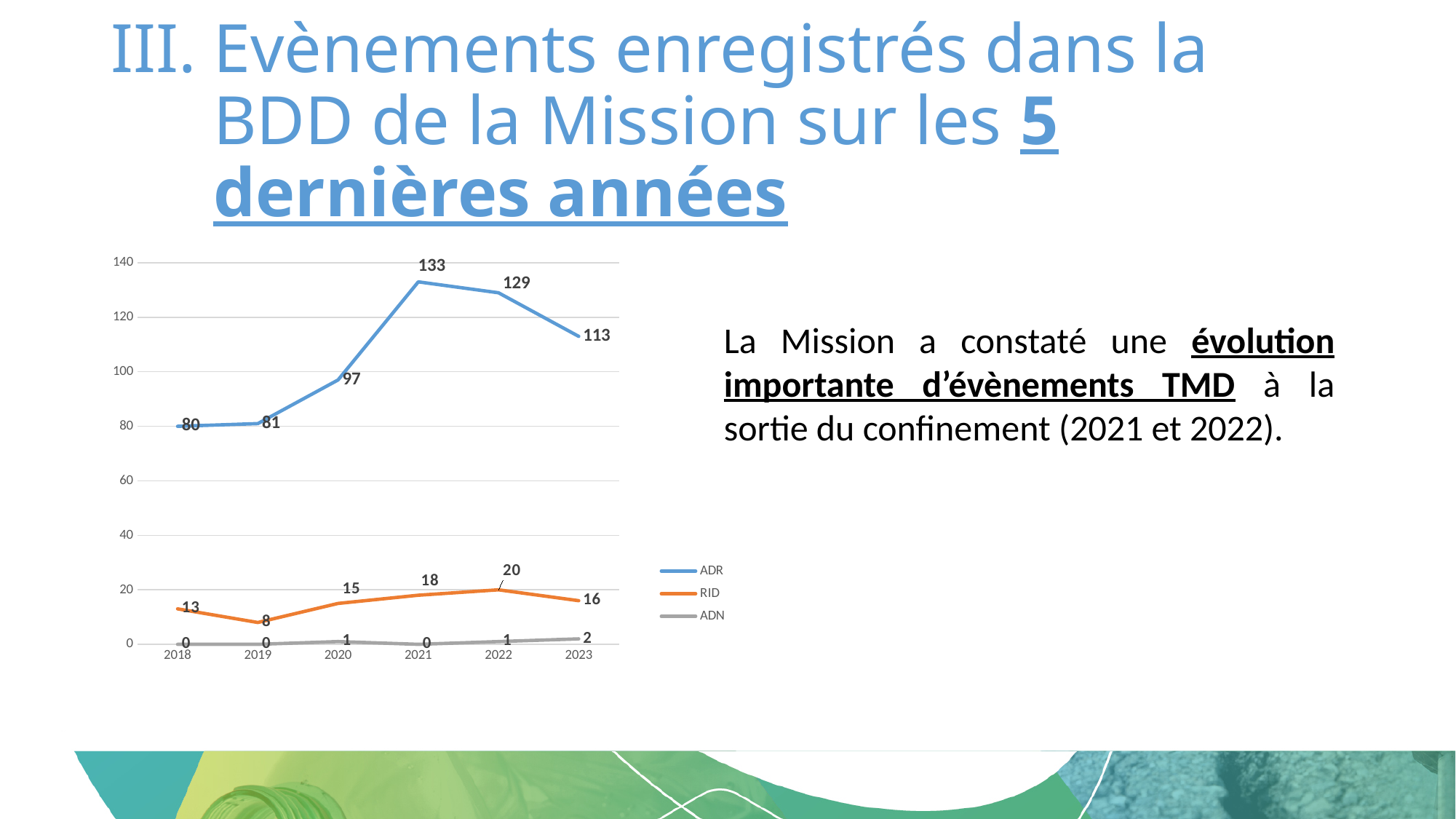
In which year is the RID series lowest? 2019 Which is larger, the RID value for 2022 or the RID value for 2018? 2022 What is the ADR value for 2021? 133 In which year is the ADR series highest? 2021 Is the ADR value for 2020 greater or less than 80? greater What is the ADN value for 2023? 2 How many series does the legend list? 3 What is the RID value for 2019? 8 Does the ADR series rise or fall from 2018 to 2021? rise What kind of chart is shown on the slide? line chart How many years are shown on the x axis? 6 What is the difference between the ADR values for 2021 and 2023? 20